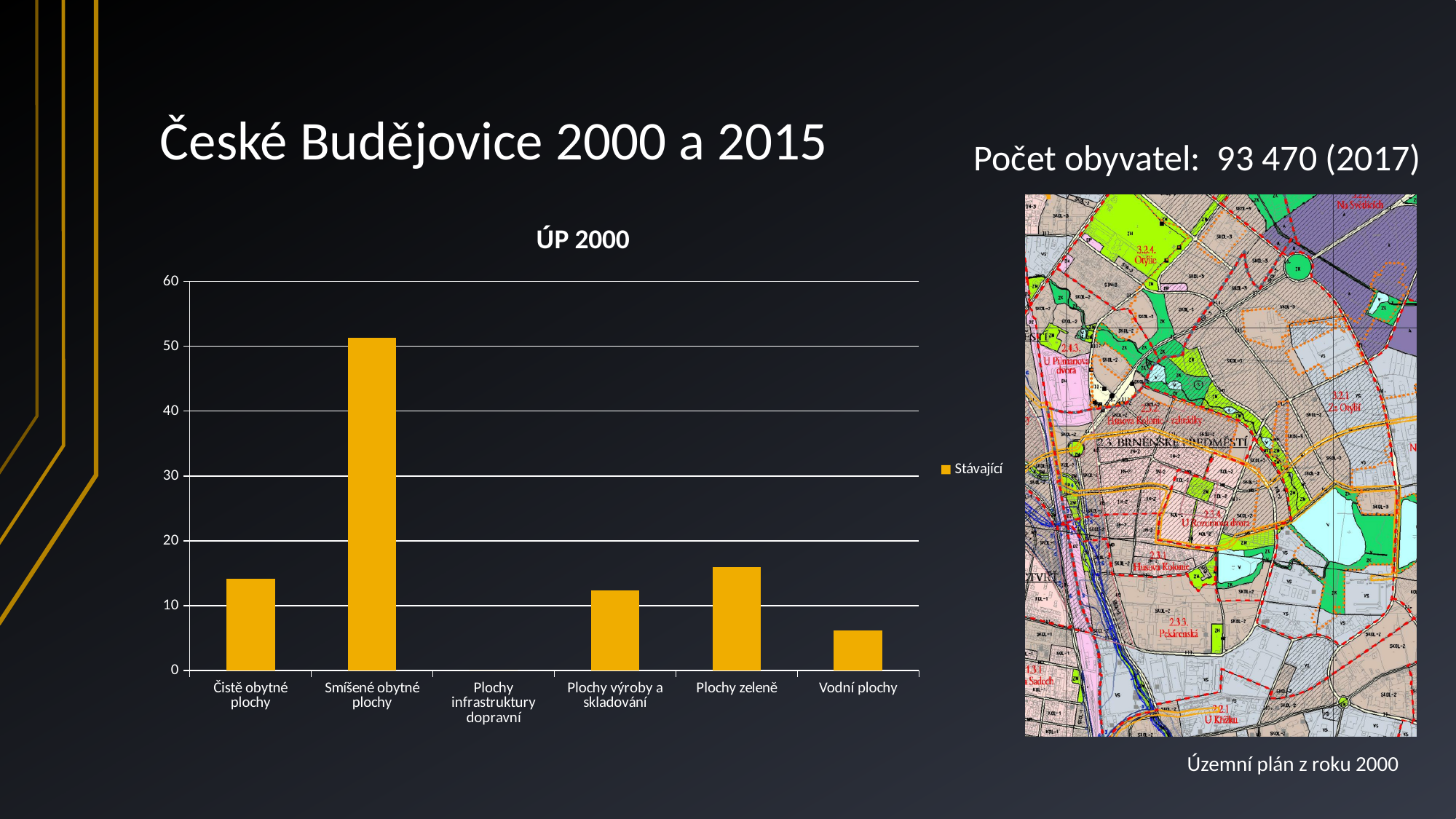
What is the title of the chart? ÚP 2000 Which is larger, the value for Čistě obytné plochy or the value for Vodní plochy? Čistě obytné plochy What is the name of the series shown in the chart legend? Stávající Is the value for Vodní plochy greater or less than 10? less Which category has the tallest bar in the chart? Smíšené obytné plochy How many categories are shown on the x axis of the chart? 6 Is the value for Plochy zeleně greater or less than 20? less Is the value for Smíšené obytné plochy greater or less than 40? greater Which category has no visible bar in the chart? Plochy infrastruktury dopravní How many series does the chart legend list? 1 What kind of chart is shown on the slide? bar chart Which is larger, the value for Plochy zeleně or the value for Plochy výroby a skladování? Plochy zeleně